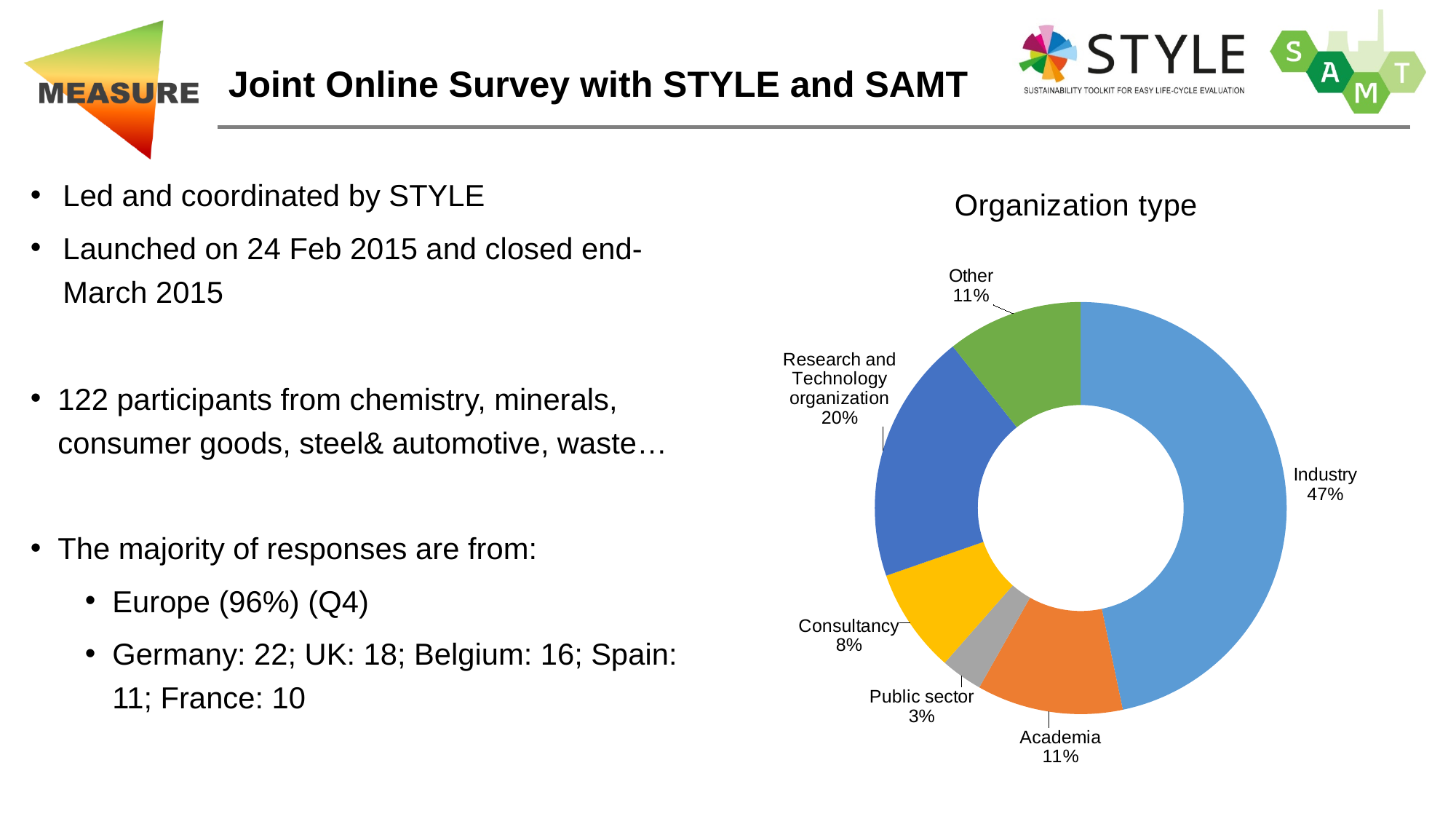
What share does Academia have in the Organization type chart? 11% What percentage of respondents are from a Research and Technology organization? 20% Which organization type has the smallest share? Public sector What share of the Organization type chart is Industry? 47% What kind of chart is used to show Organization type? Doughnut (pie) chart How many percentage points larger is Industry's share than Research and Technology organization's share? 27 How many organization types are shown in the chart? 6 What share does Consultancy have in the Organization type chart? 8% What is the title of the chart on the slide? Organization type What percentage is shown for Public sector? 3% Which has a larger share, Consultancy or Academia? Academia Which organization type has the largest share? Industry